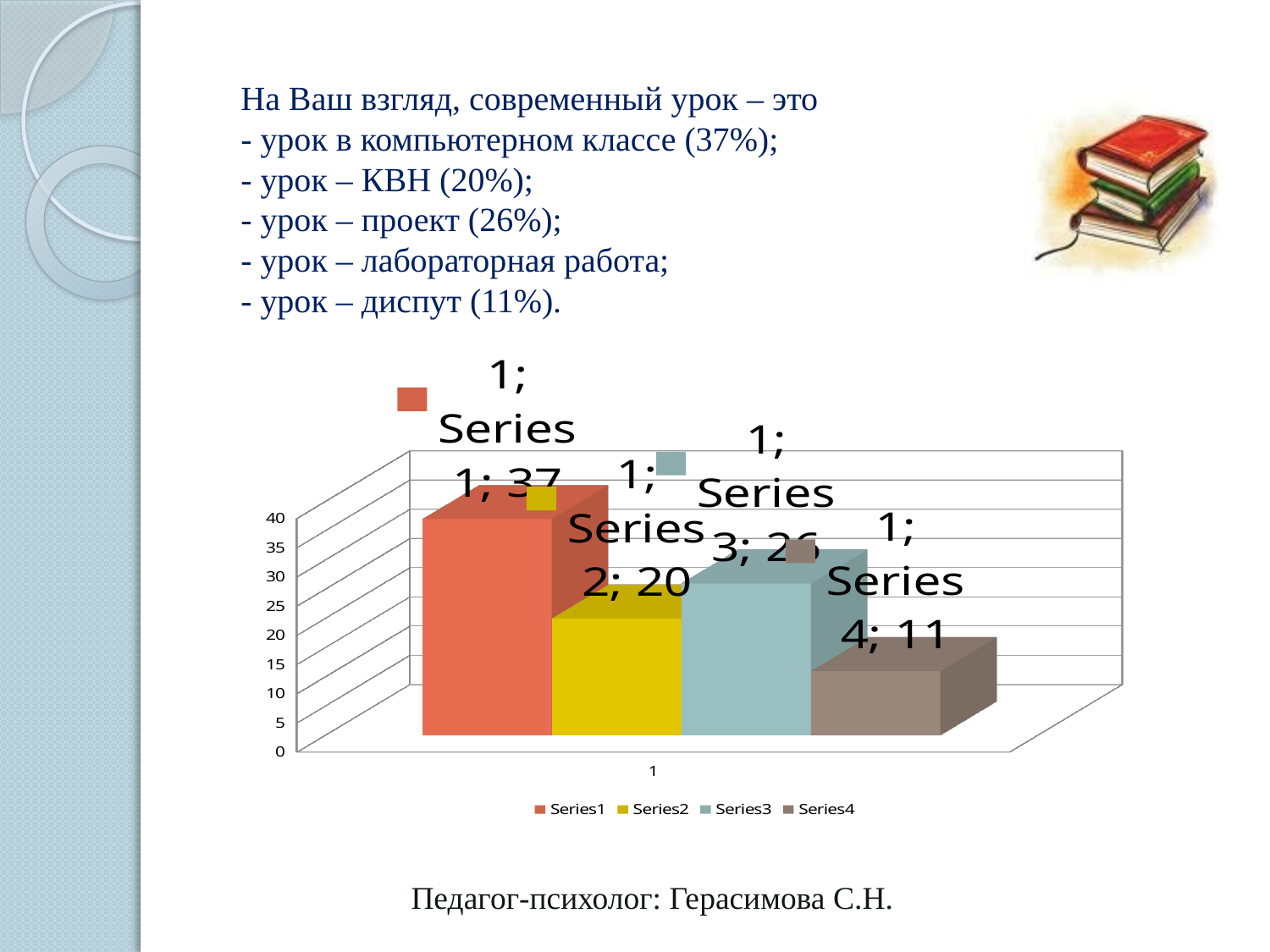
What is the difference between the values for Series2 and Series4? 9 What is the difference between the values for Series1 and Series2? 17 Which is larger, the value for Series2 or the value for Series3? Series3 What is the value for Series2 in the chart? 20 What is the maximum value shown on the chart's vertical axis? 40 Is the value for Series3 greater or less than 20? greater What is the value for Series4 in the chart? 11 Which series has the lowest value in the chart? Series4 Which series has the highest value in the chart? Series1 What type of chart is shown on the slide? bar chart How many series does the chart legend list? 4 What is the value for Series1 in the chart? 37